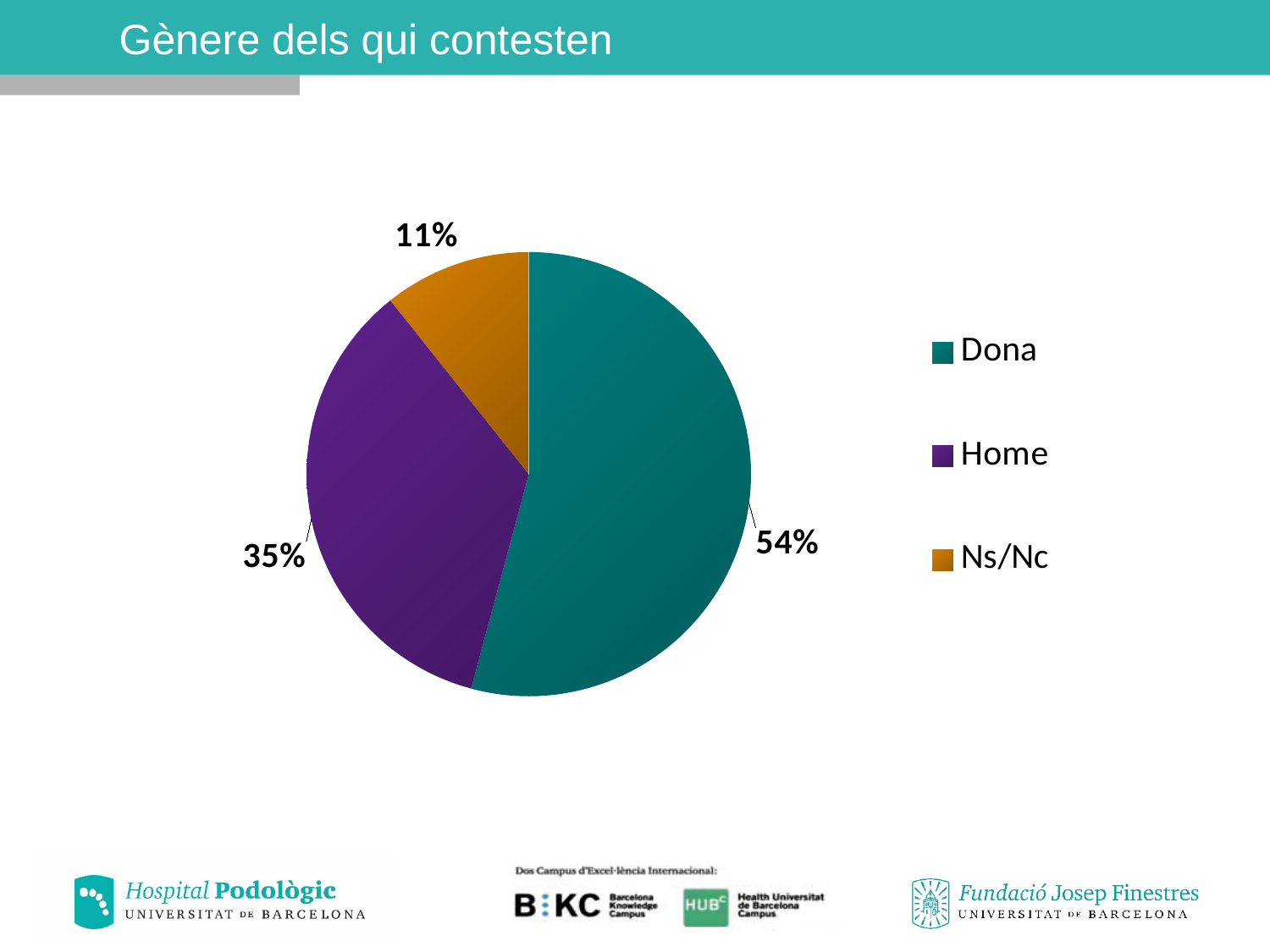
Which is larger, the Home slice or the Ns/Nc slice? Home What is the difference in percentage points between the Home and Ns/Nc slices? 24 What share of the pie does Dona represent? 54% Which category is shown in purple in the legend? Home How many categories does the pie chart have? 3 What kind of chart is shown on the slide? pie chart Which category has the smallest slice of the pie? Ns/Nc Which category has the largest slice of the pie? Dona What share of the pie does Home represent? 35% What share of the pie does Ns/Nc represent? 11% What is the difference in percentage points between the Dona and Home slices? 19 What is the title of the slide containing the chart? Gènere dels qui contesten